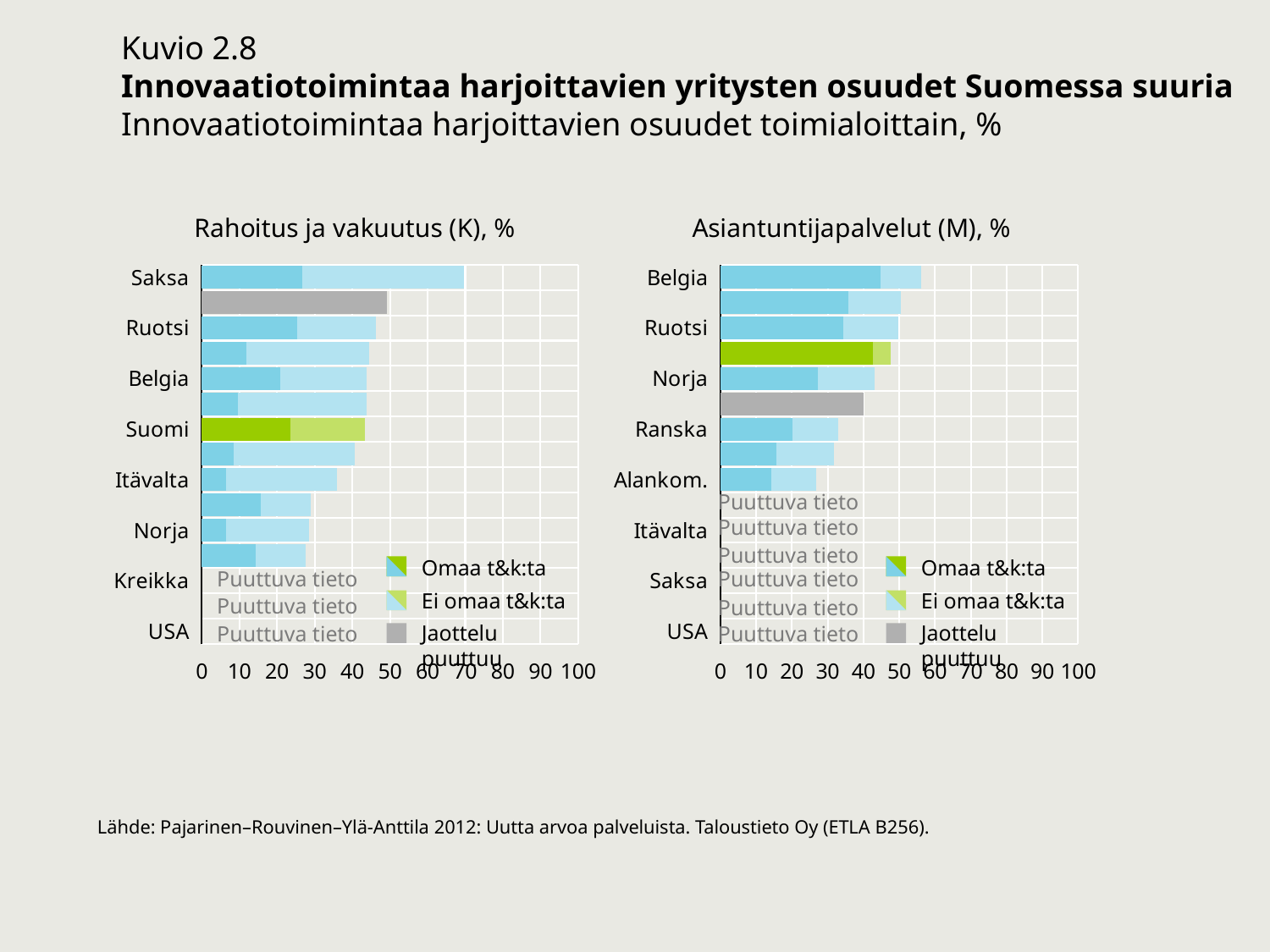
What kind of chart is the 'Rahoitus ja vakuutus (K), %' chart? bar chart In the 'Rahoitus ja vakuutus (K), %' chart, is the total bar for Saksa greater or less than 60? greater In the 'Asiantuntijapalvelut (M), %' chart, is the total bar for Belgia greater or less than 50? greater How many series does the legend of the 'Asiantuntijapalvelut (M), %' chart list? 3 In the 'Rahoitus ja vakuutus (K), %' chart, is the total bar for Suomi greater or less than 50? less In the 'Asiantuntijapalvelut (M), %' chart, which has the longer bar, Belgia or Norja? Belgia In the 'Asiantuntijapalvelut (M), %' chart, which labelled country has the longest bar? Belgia In the 'Rahoitus ja vakuutus (K), %' chart, which labelled countries are marked 'Puuttuva tieto' instead of a bar? Kreikka and USA In the 'Rahoitus ja vakuutus (K), %' chart, which has the longer bar, Saksa or Suomi? Saksa In the 'Rahoitus ja vakuutus (K), %' chart, which labelled country has the longest bar? Saksa